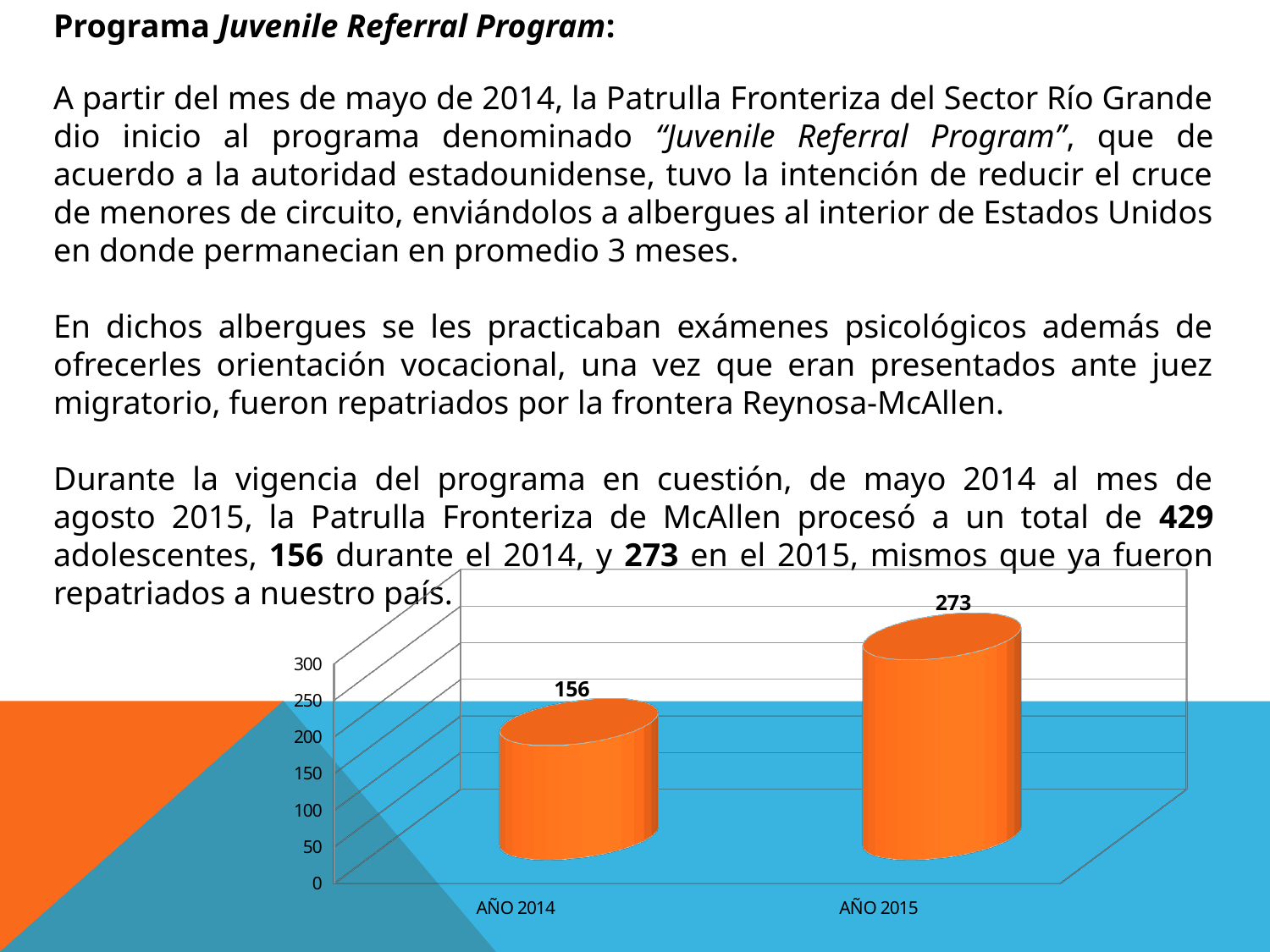
Which category has the lowest value? AÑO 2014 What is the difference between the values for AÑO 2015 and AÑO 2014? 117 How many categories are shown on the x axis? 2 Which category has the highest value? AÑO 2015 What is the maximum value shown on the vertical axis? 300 What is the value for AÑO 2014? 156 What kind of chart is shown on the slide? bar chart Is the value for AÑO 2015 greater or less than 250? greater Do the values rise or fall from AÑO 2014 to AÑO 2015? rise Is the value for AÑO 2014 greater or less than 200? less What is the value for AÑO 2015? 273 Which is larger, the value for AÑO 2014 or AÑO 2015? AÑO 2015